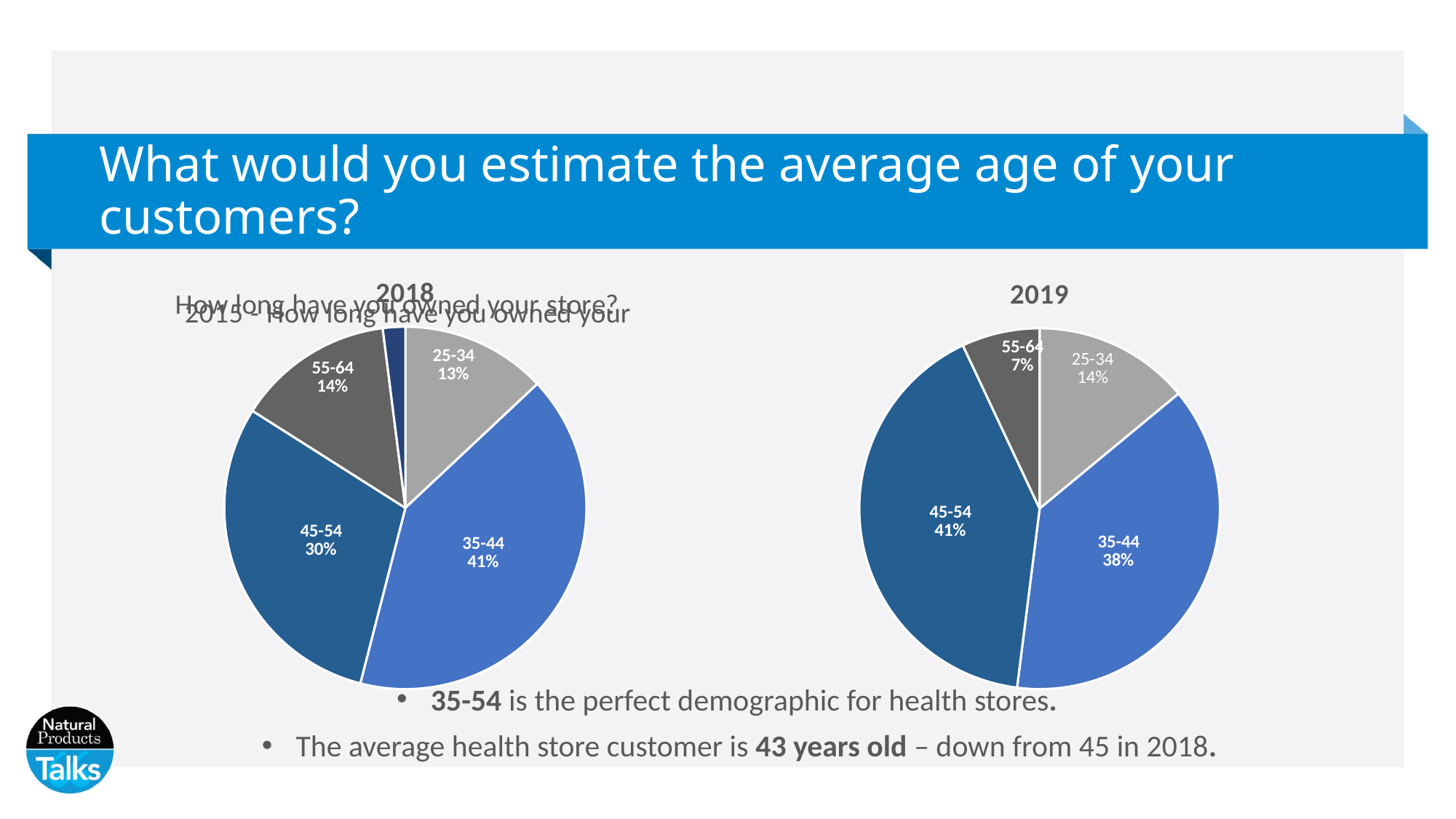
In the 2018 pie chart, which is larger: the 55-64 share or the 25-34 share? 55-64 In the 2018 pie chart, what share of customers is in the 35-44 age group? 41% In the 2019 pie chart, which age group has the smallest share? 55-64 In the 2019 pie chart, what share of customers is in the 25-34 age group? 14% In the 2019 pie chart, how many percentage points larger is the 45-54 share than the 35-44 share? 3 percentage points What type of chart is used for the 2018 data? Pie chart In the 2019 pie chart, what share of customers is in the 55-64 age group? 7% In the 2019 pie chart, which age group has the largest share? 45-54 In the 2018 pie chart, which age group has the largest share? 35-44 How many labeled slices does the 2019 pie chart have? 4 In the 2018 pie chart, how many percentage points larger is the 35-44 share than the 45-54 share? 11 percentage points In the 2018 pie chart, what share of customers is in the 45-54 age group? 30%